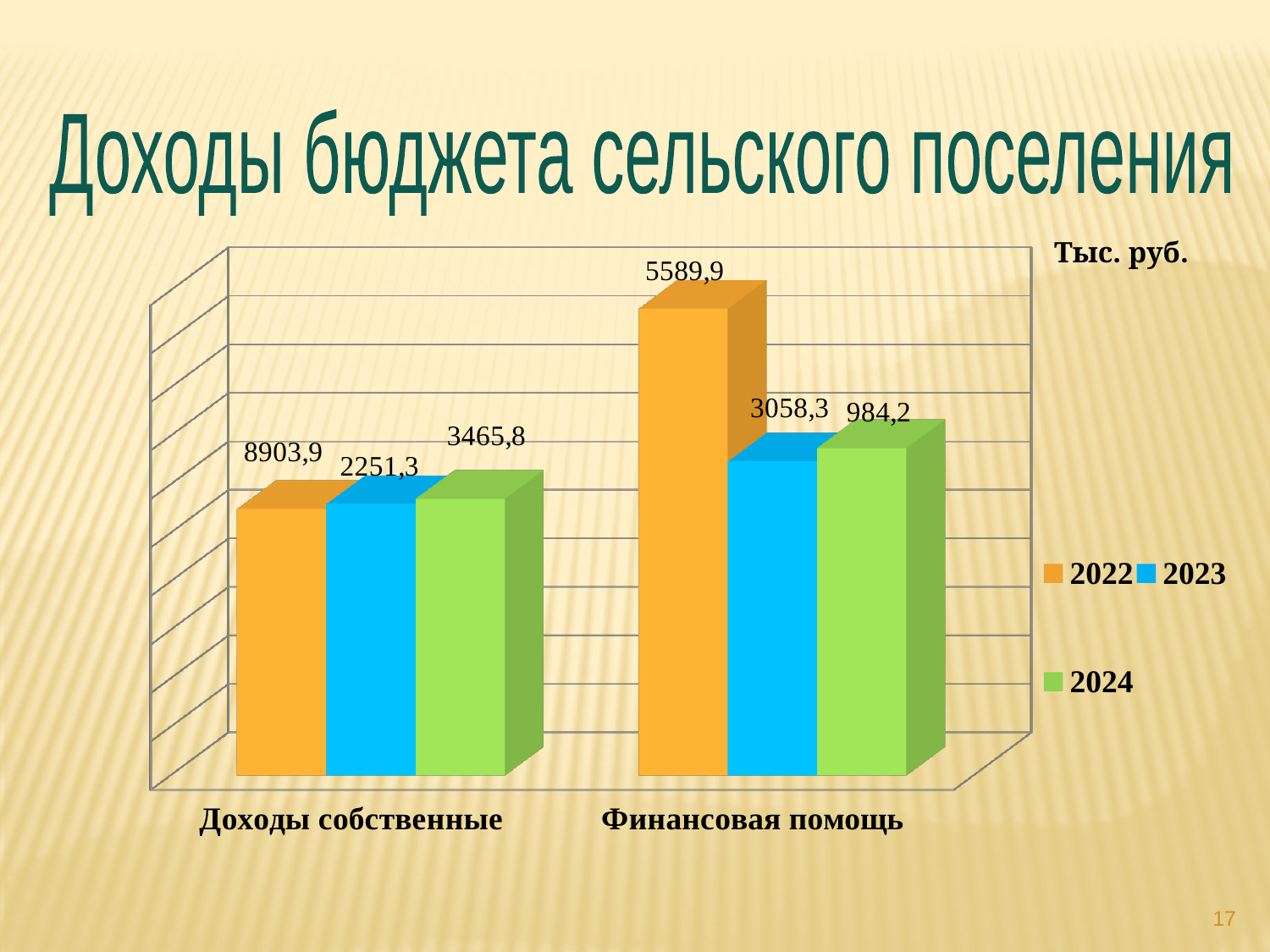
What is the value for 2022 in the Доходы собственные category? 8903,9 What kind of chart is shown on the slide? Bar chart What unit is indicated for the values on the chart? Тыс. руб. What is the difference between the 2022 and 2023 values in the Финансовая помощь category? 2531,6 How many series does the legend list? 3 What is the value for 2024 in the Финансовая помощь category? 984,2 How many categories are shown on the x axis? 2 What is the value for 2022 in the Финансовая помощь category? 5589,9 What is the value for 2024 in the Доходы собственные category? 3465,8 In the Финансовая помощь category, which year has the highest value? 2022 What is the value for 2023 in the Финансовая помощь category? 3058,3 What is the value for 2023 in the Доходы собственные category? 2251,3